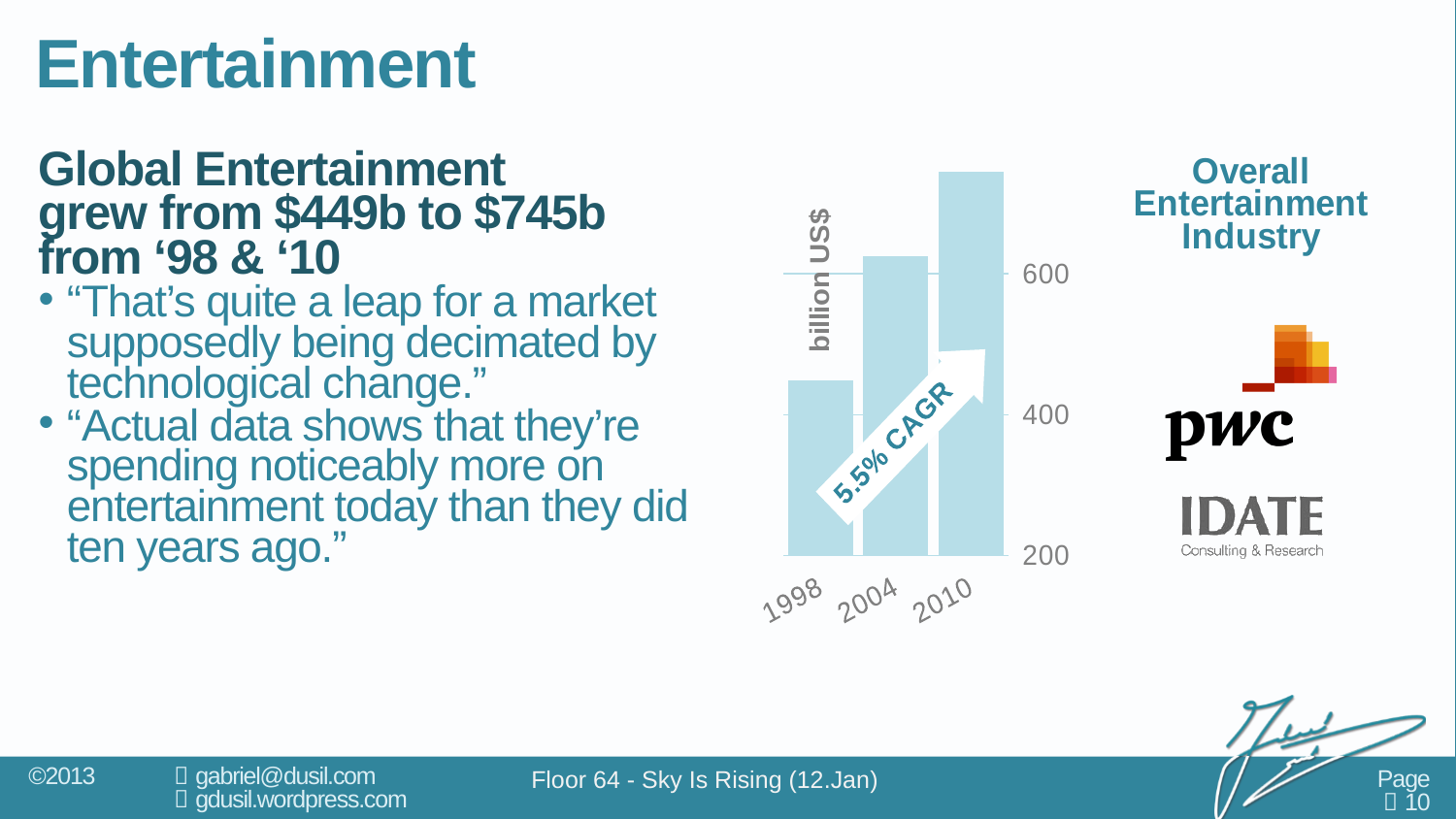
What growth rate is written on the arrow across the chart? 5.5% CAGR Which year has the lowest bar in the chart? 1998 Which is larger in the chart, the value for 1998 or the value for 2010? 2010 Is the value for 1998 greater or less than 600? less Which is larger in the chart, the value for 2004 or the value for 1998? 2004 Is the value for 2010 greater or less than 600? greater What is the label on the vertical axis of the chart? billion US$ Which year has the highest bar in the chart? 2010 How many years (bars) are plotted in the chart? 3 Do the values rise or fall from 1998 to 2010 in the chart? rise Is the value for 1998 greater or less than 400? greater What kind of chart is shown on the slide? bar chart